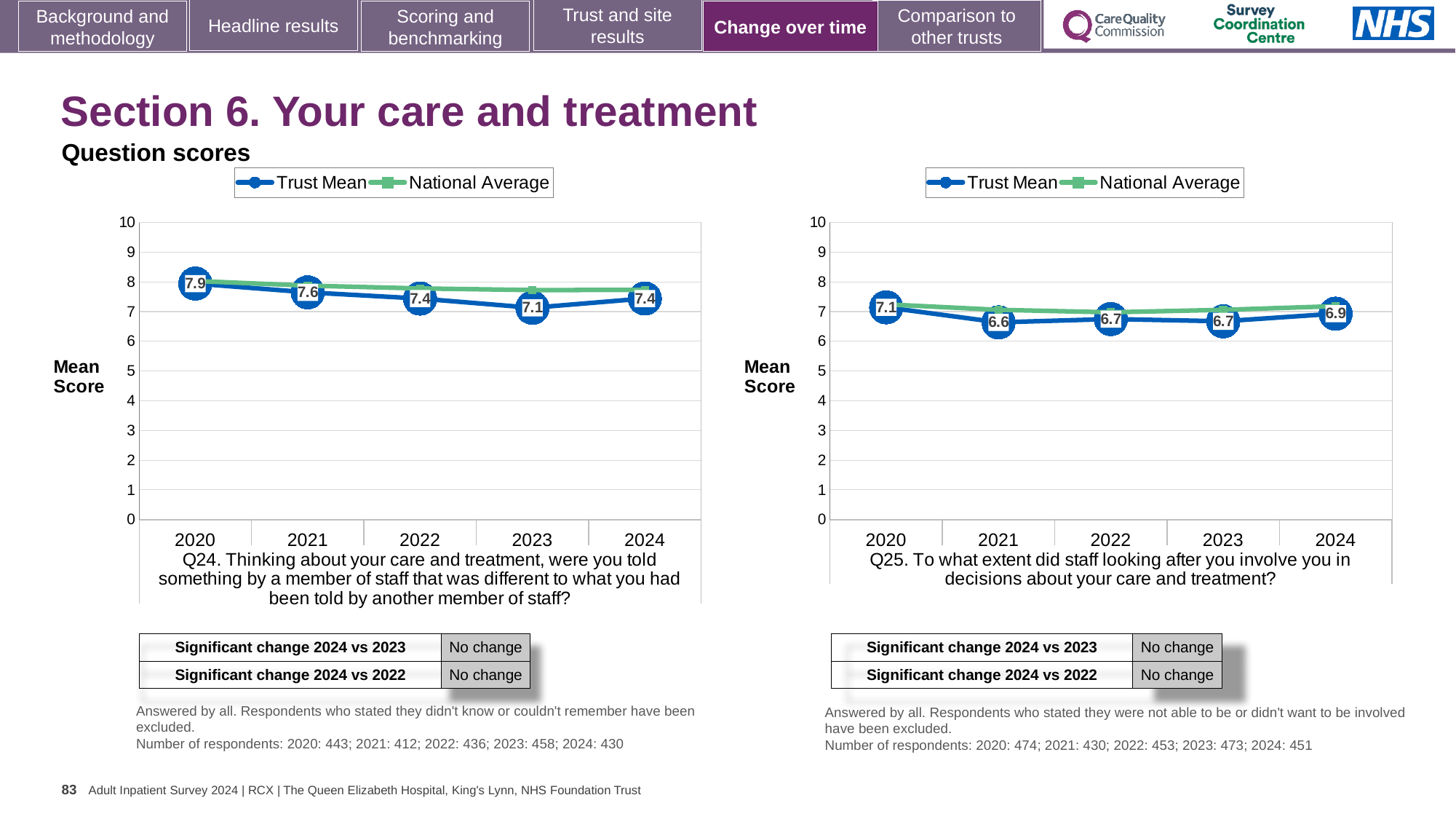
In the Q24 chart (left), what is the difference between the Trust Mean scores for 2020 and 2023? 0.8 In the Q25 chart (right), which is larger, the Trust Mean score for 2020 or for 2024? 2020 In the Q25 chart (right), is the National Average for 2020 greater or less than 6? greater How many series does the legend of the Q25 chart (right) list? 2 In the Q24 chart (left), what is the Trust Mean score for 2023? 7.1 In the Q24 chart (left), which year has the highest Trust Mean score? 2020 In the Q25 chart (right), which year has the lowest Trust Mean score? 2021 In the Q25 chart (right), what is the Trust Mean score for 2024? 6.9 In the Q24 chart (left), what is the Trust Mean score for 2020? 7.9 What type of chart is the Q24 chart (left)? Line chart How many years are shown on the x axis of the Q24 chart (left)? 5 In the Q25 chart (right), what is the Trust Mean score for 2021? 6.6